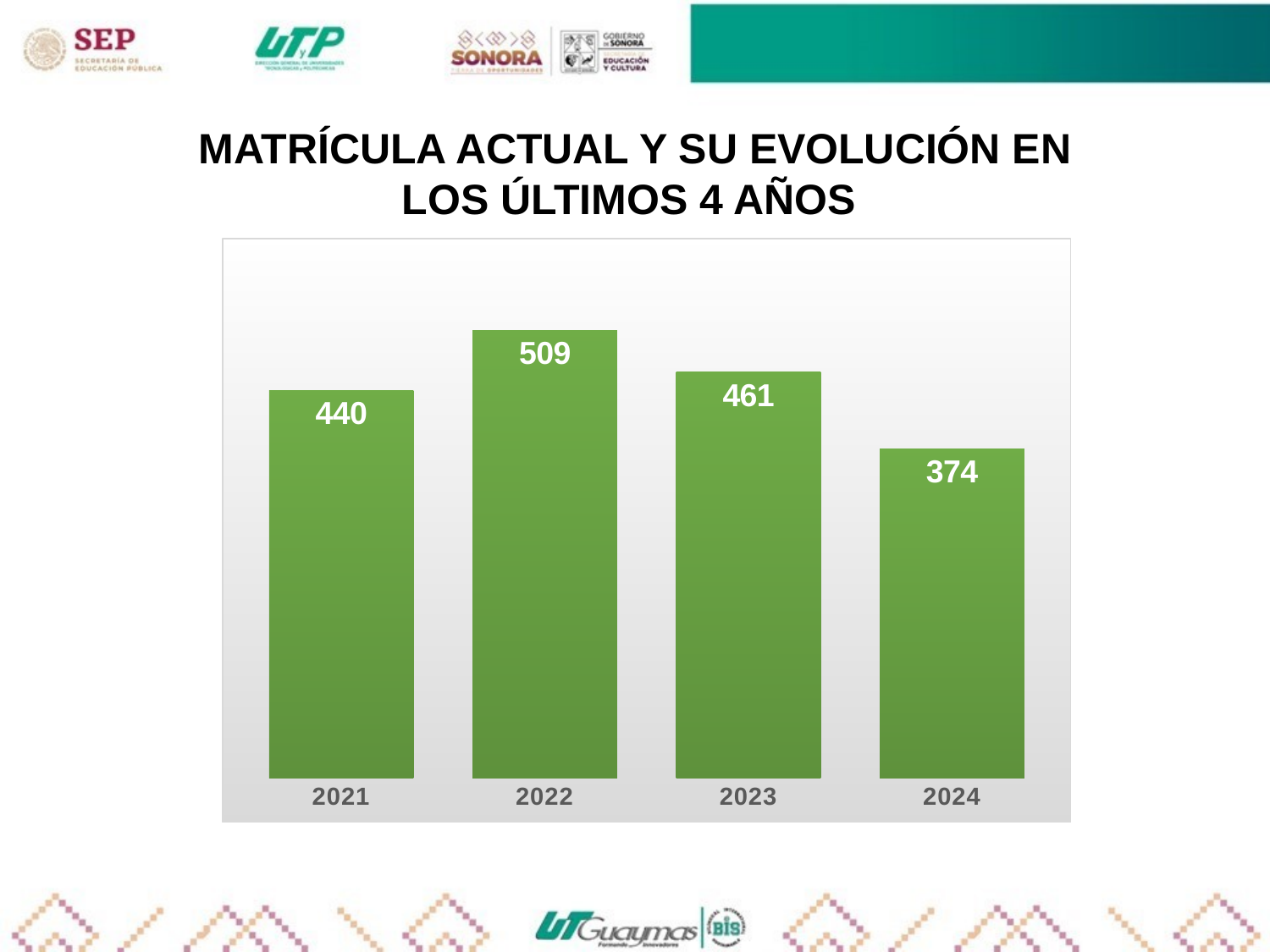
Which year has the highest value? 2022 What is the difference between the values for 2023 and 2021? 21 What is the difference between the values for 2022 and 2024? 135 Which is larger, the value for 2021 or the value for 2023? 2023 Which year has the lowest value? 2024 What kind of chart is shown on the slide? bar chart How many years are shown on the chart? 4 What is the value for 2024? 374 Do the values rise or fall from 2022 to 2024? fall What is the value for 2023? 461 What is the value for 2021? 440 What is the value for 2022? 509